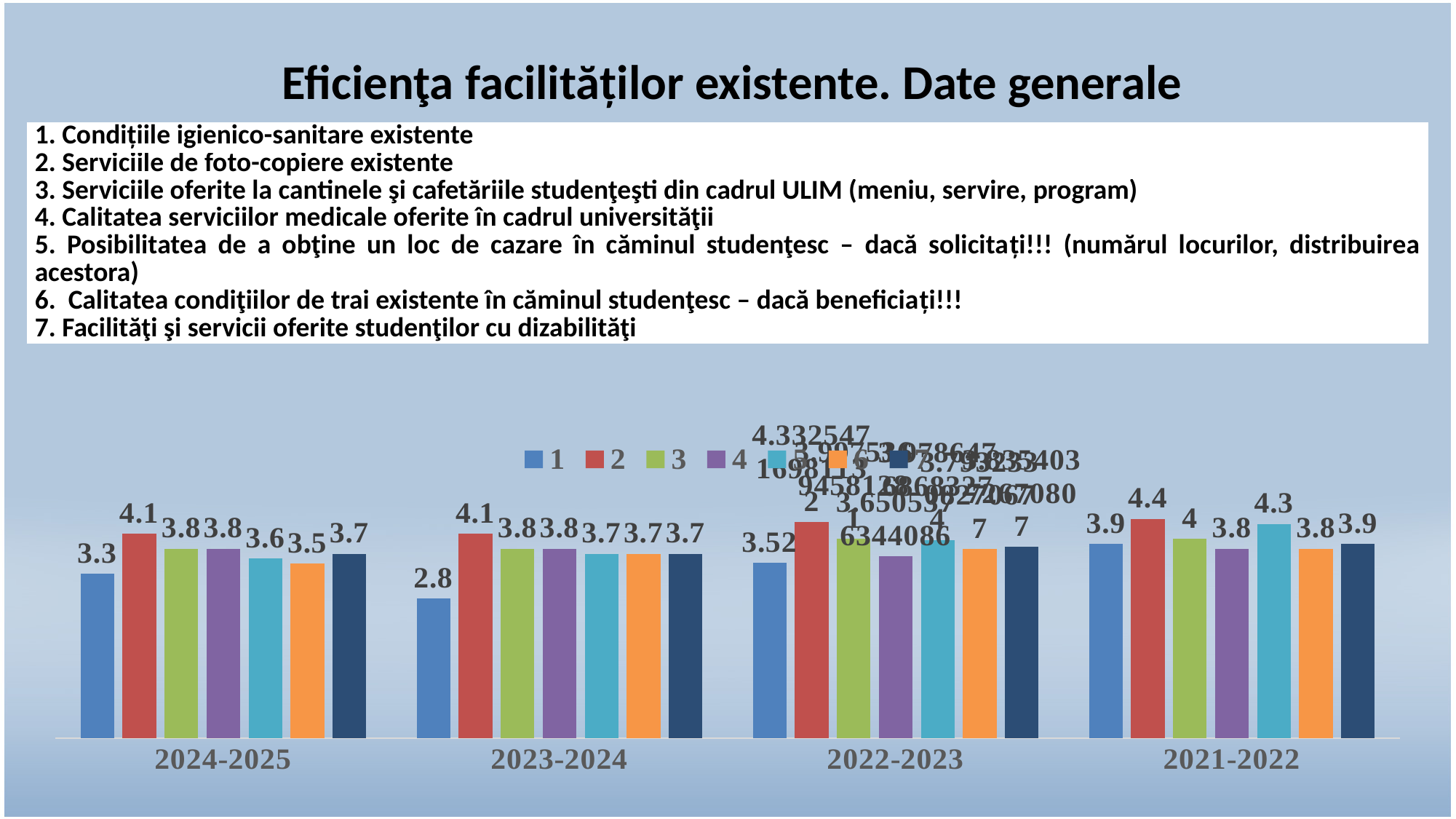
What is the value for series 1 in 2024-2025? 3.3 What type of chart is shown on the slide? bar chart Which series has the highest value in 2024-2025? 2 What is the difference between series 2 and series 1 in 2023-2024? 1.3 What is the value for series 5 in 2021-2022? 4.3 How many series does the chart legend list? 7 How many academic-year categories are shown on the x axis? 4 What is the value for series 2 in 2021-2022? 4.4 Which category on the x axis is listed first (leftmost)? 2024-2025 Which is larger in 2021-2022: series 2 or series 5? series 2 What is the value for series 1 in 2023-2024? 2.8 Which series has the lowest value in 2023-2024? 1